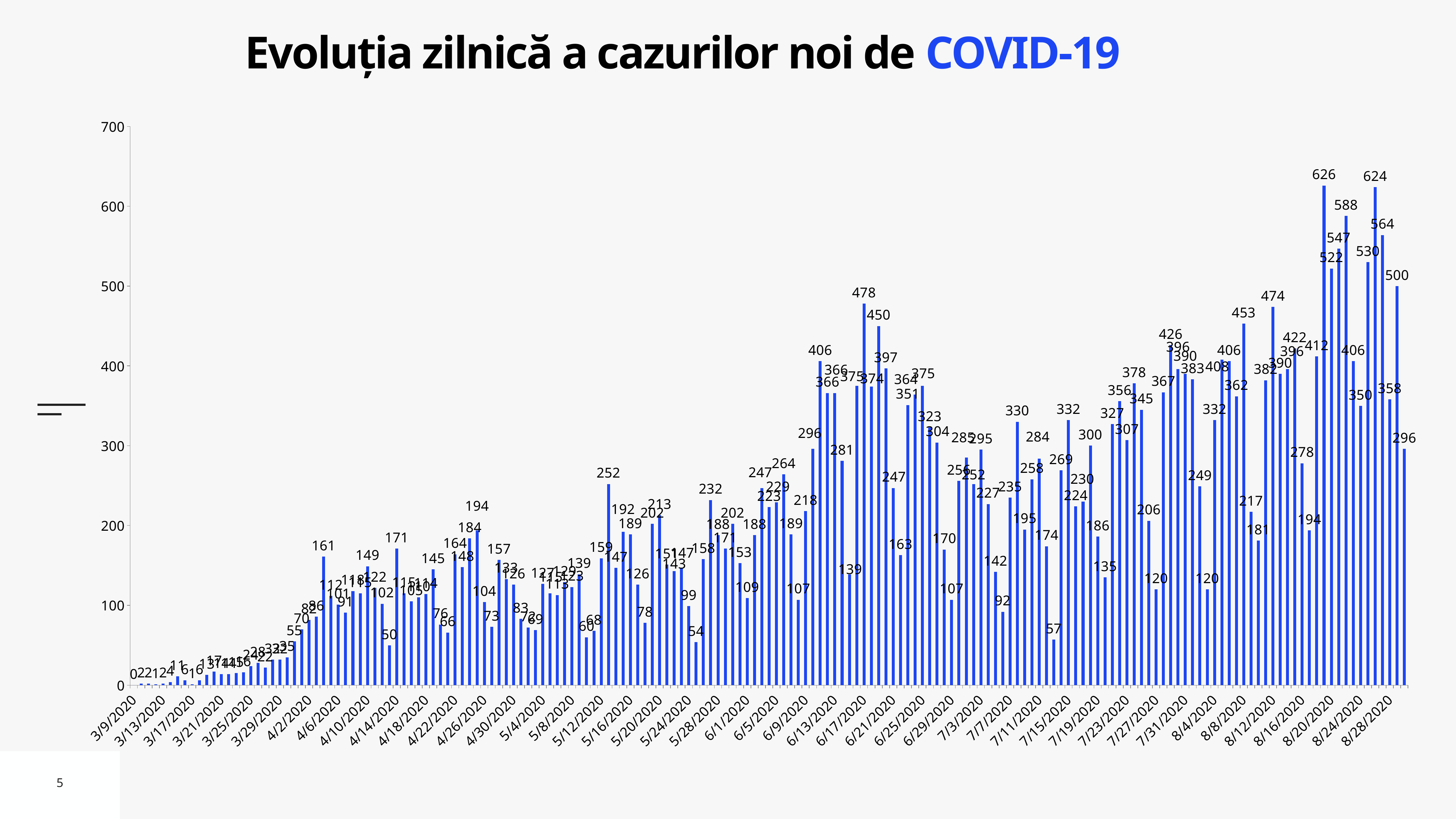
Is the highest bar on the chart greater or less than 600? greater What is the highest daily value shown on the chart? 626 What is the value of the first bar, for 3/9/2020? 0 Overall, do the daily values rise or fall from March to August 2020? rise What is the maximum value shown on the vertical axis? 700 What is the title of the chart? Evoluția zilnică a cazurilor noi de COVID-19 Which is larger, the highest value in June (478) or the highest value in August (626)? 626 What kind of chart is shown on the slide? bar chart What is the difference between the two highest values on the chart, 626 and 624? 2 What is the value of the last bar on the chart? 296